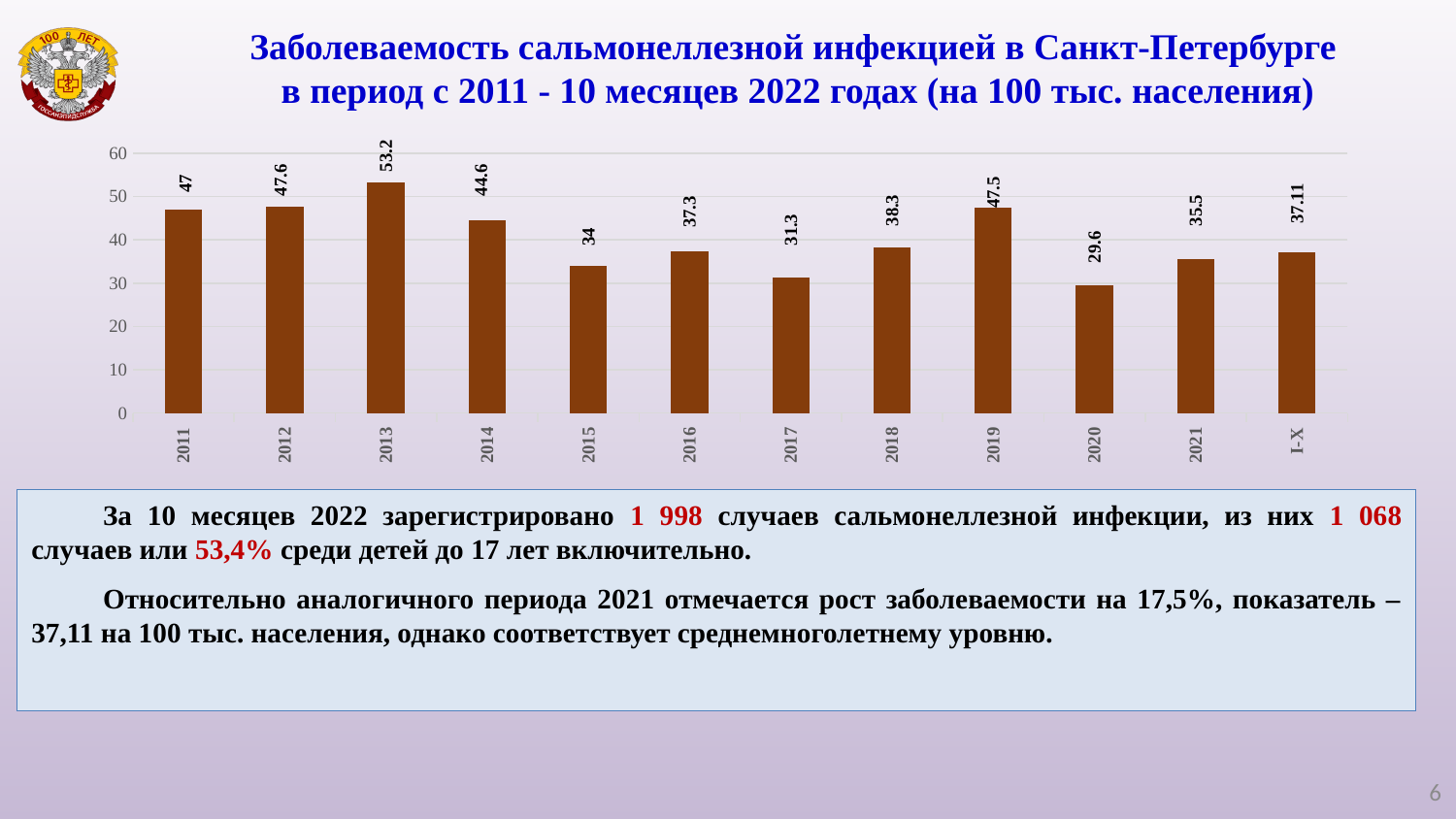
What is the value for 2020? 29.6 What is the difference between the values for 2013 and 2020? 23.6 Which year has the highest value? 2013 Is the value for 2017 greater or less than 40? less Which is larger, the value for 2018 or the value for 2016? 2018 What kind of chart is shown on the slide? bar chart What is the value for the I-X category? 37.11 Which category has the lowest value? 2020 Do the values rise or fall from 2019 to 2020? fall What is the difference between the values for 2012 and 2011? 0.6 What is the value for 2013? 53.2 How many bars are shown in the chart? 12